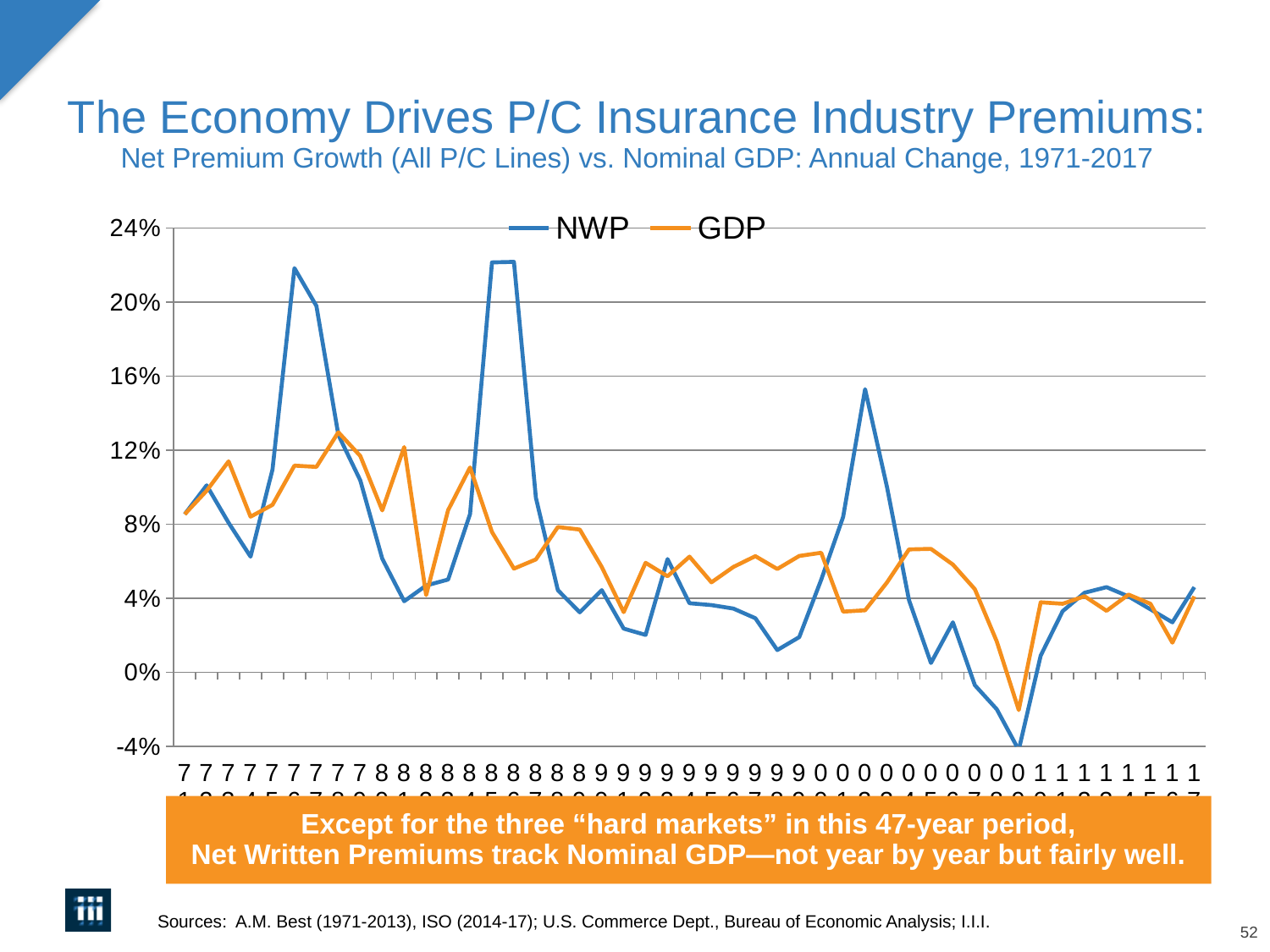
How many years does the chart cover? 47 Is the lowest value of the GDP line greater or less than 0%? less Which series reaches the highest value anywhere on the chart? NWP Is the highest value of the NWP line greater or less than 20%? greater Over the whole period, do the NWP and GDP growth rates generally rise or fall from left to right? Fall Is the lowest value of the NWP line greater or less than 0%? less What kind of chart is shown on the slide? Line chart Which series reaches the lowest value anywhere on the chart? NWP Which colour is used for the GDP line? Orange What is the highest value shown on the vertical axis? 24% What are the two series named in the legend? NWP and GDP How many series does the legend list? 2